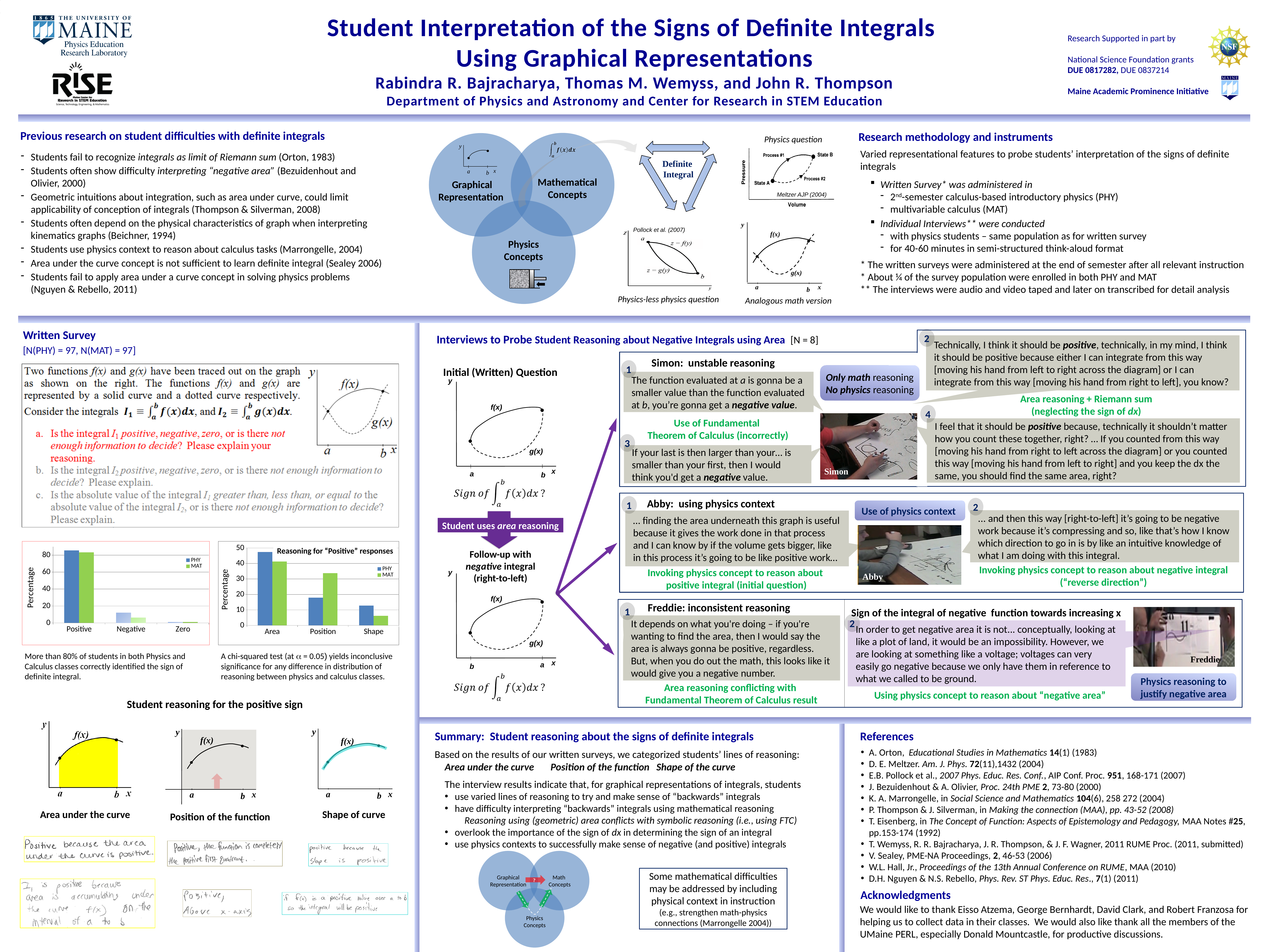
In the left bar chart of the Written Survey section, is the PHY value for Positive greater or less than 80? greater In the 'Reasoning for "Positive" responses' chart, which category has the highest PHY value? Area In the 'Reasoning for "Positive" responses' chart, is the PHY value for Area greater or less than 40? greater What kind of chart is the 'Reasoning for "Positive" responses' chart? bar chart In the 'Reasoning for "Positive" responses' chart, which is larger for the Position category, PHY or MAT? MAT In the 'Reasoning for "Positive" responses' chart, is the MAT value for Shape greater or less than 10? less How many series does the legend list in the 'Reasoning for "Positive" responses' chart? 2 In the left bar chart of the Written Survey section, which is larger for the Negative category, PHY or MAT? PHY How many categories are shown on the x axis of the left bar chart in the Written Survey section? 3 In the left bar chart of the Written Survey section, which category has the lowest value for the MAT series? Zero In the left bar chart of the Written Survey section, which category has the highest value for the PHY series? Positive